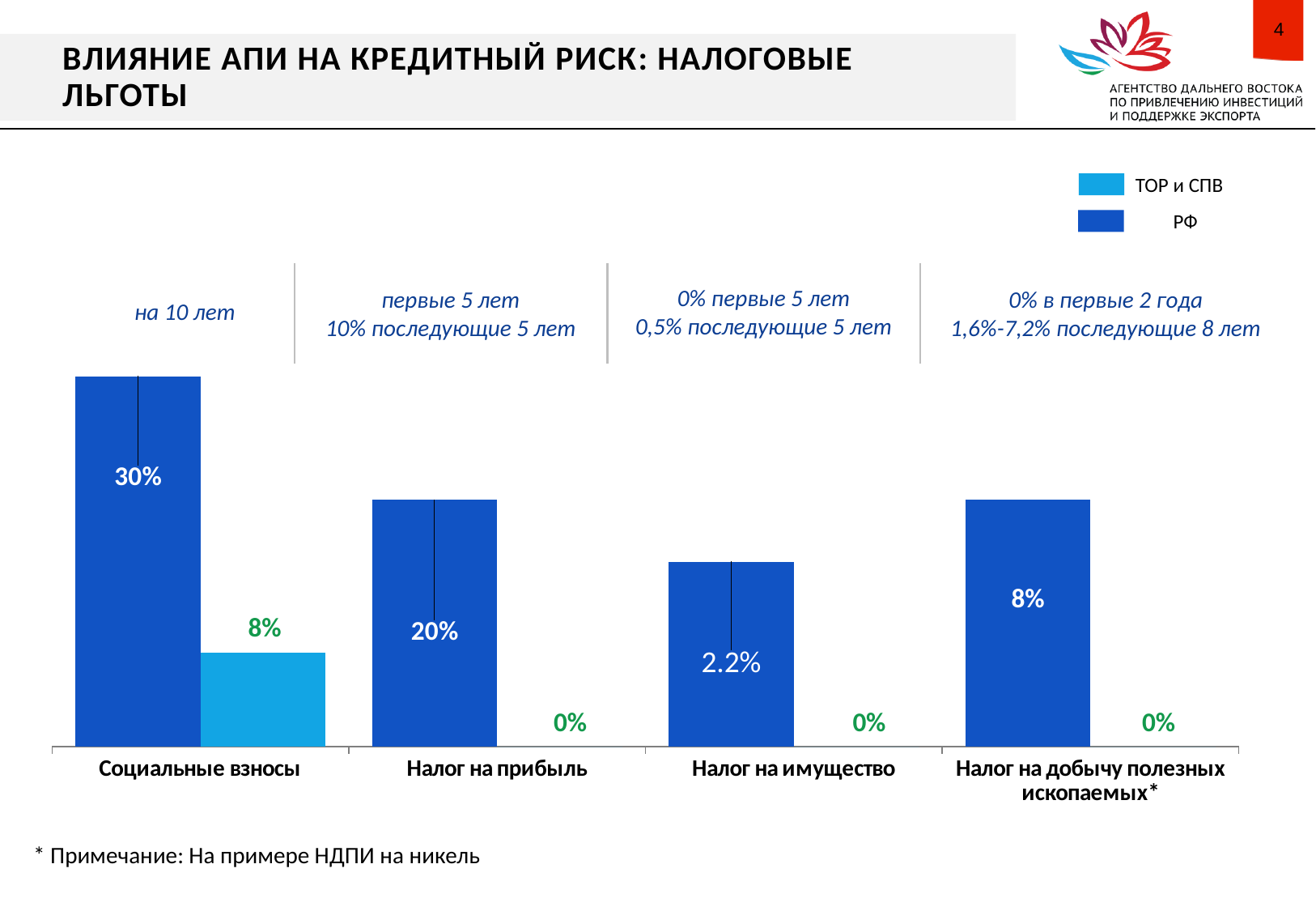
What kind of chart is shown on the slide? Bar chart What is the РФ value for Налог на прибыль? 20% What is the ТОР и СПВ value for Социальные взносы? 8% Which category has the highest РФ value? Социальные взносы Which is larger: the РФ value for Налог на прибыль or the РФ value for Налог на имущество? Налог на прибыль What is the РФ value for Налог на имущество? 2.2% Which category has the lowest РФ value? Налог на имущество How many categories are shown on the x axis? 4 How many series does the legend list? 2 What is the ТОР и СПВ value for Налог на добычу полезных ископаемых? 0% What is the difference between the РФ and ТОР и СПВ values for Социальные взносы? 22% What is the РФ value for Социальные взносы? 30%